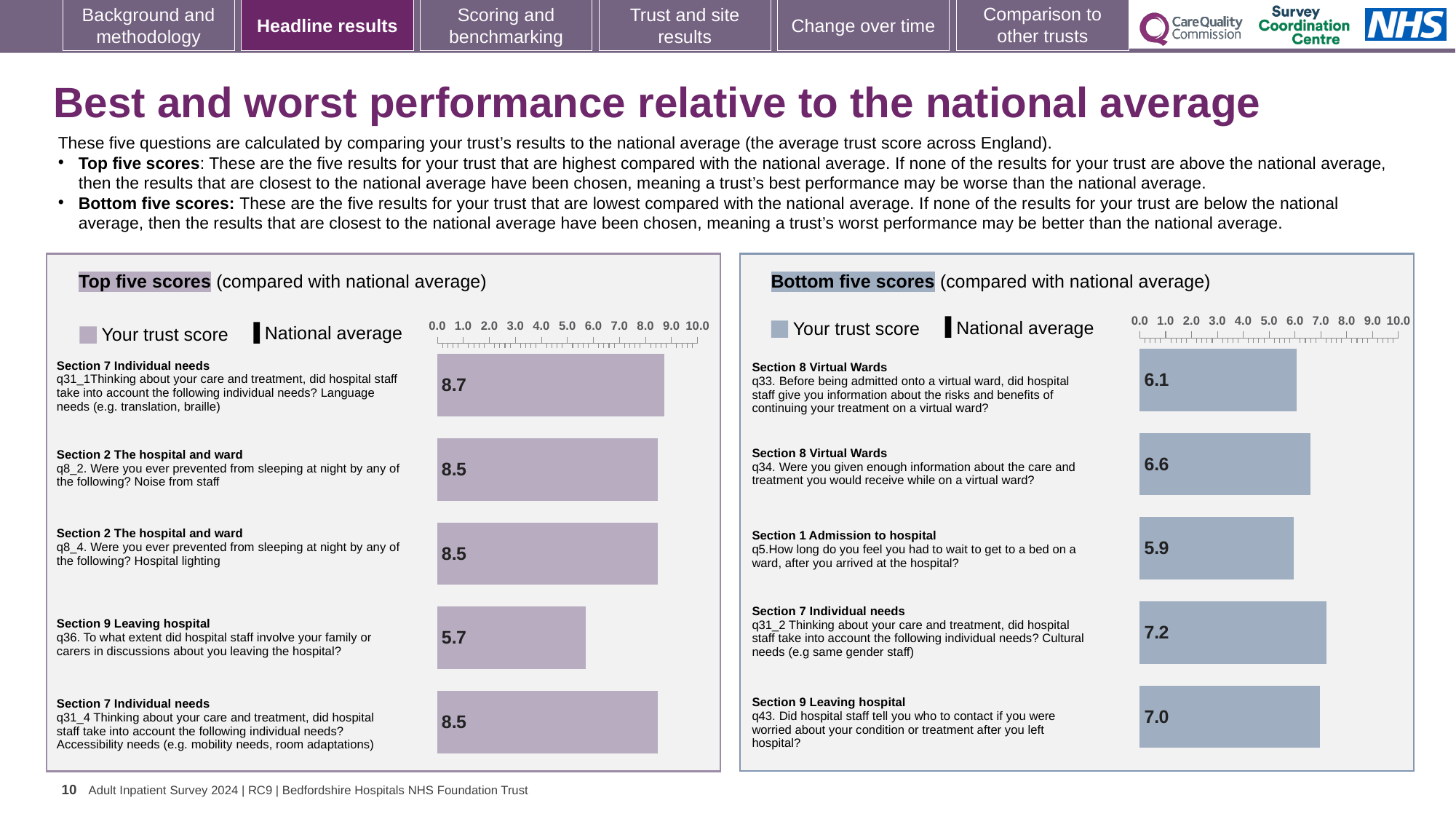
In the Bottom five scores chart, what is the trust score for q33 (information about risks and benefits of a virtual ward)? 6.1 In the Top five scores chart, what is the trust score for q31_1 (Language needs, e.g. translation, braille)? 8.7 In the Bottom five scores chart, which question has the lowest trust score? q5 (Section 1 Admission to hospital), 5.9 In the Bottom five scores chart, what is the trust score for q43 (who to contact if worried after leaving hospital)? 7.0 In the Top five scores chart, which question has the lowest trust score? q36 (Section 9 Leaving hospital), 5.7 In the Top five scores chart, what is the trust score for q36 (involving family or carers in discussions about leaving hospital)? 5.7 In the Top five scores chart, which question has the highest trust score? q31_1 Language needs (Section 7 Individual needs), 8.7 In the Top five scores chart, what is the difference between the trust score for q31_1 (Language needs) and q36 (Leaving hospital)? 3.0 In the Bottom five scores chart, which has the larger trust score: q34 or q33? q34 (6.6) In the Bottom five scores chart, which question has the highest trust score? q31_2 Cultural needs (Section 7 Individual needs), 7.2 In the Bottom five scores chart, what is the difference between the trust scores for q31_2 (Cultural needs) and q5 (wait for a bed)? 1.3 What type of chart is used in the Top five scores panel? Bar chart